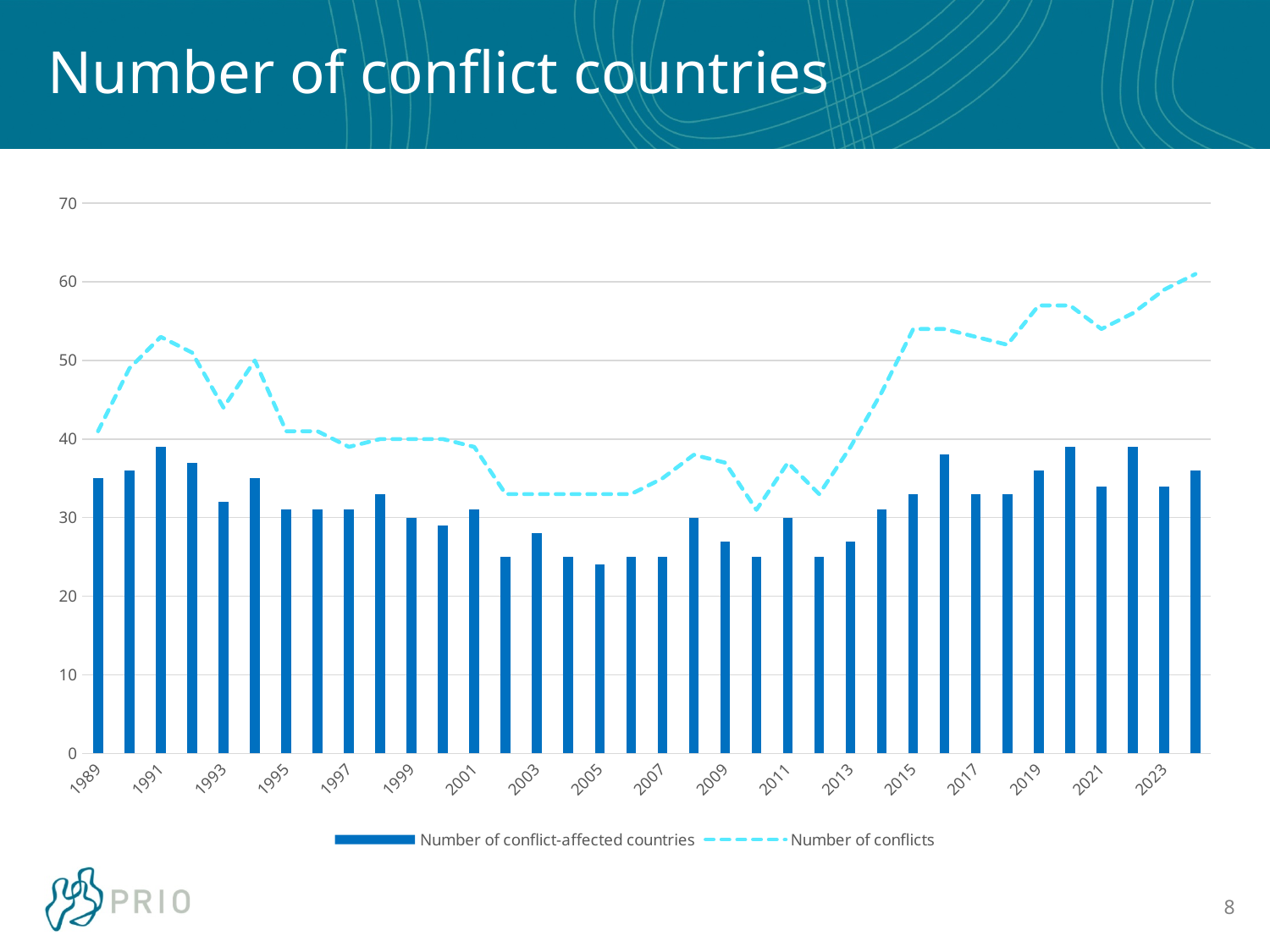
How many years (bars) are plotted for the number of conflict-affected countries? 36 Is the number of conflict-affected countries in 1991 greater or less than 30? greater In which year is the number of conflicts highest? 2024 What kind of chart is shown on the slide? A combined bar and line chart Which year has more conflict-affected countries, 1991 or 2005? 1991 Is the number of conflicts in 2023 greater or less than 50? greater Is the number of conflict-affected countries in 2005 greater or less than 30? less Does the number of conflicts rise or fall between 2013 and 2015? rise How many series does the legend list? 2 What are the two series named in the legend? Number of conflict-affected countries; Number of conflicts What is the title of the slide? Number of conflict countries